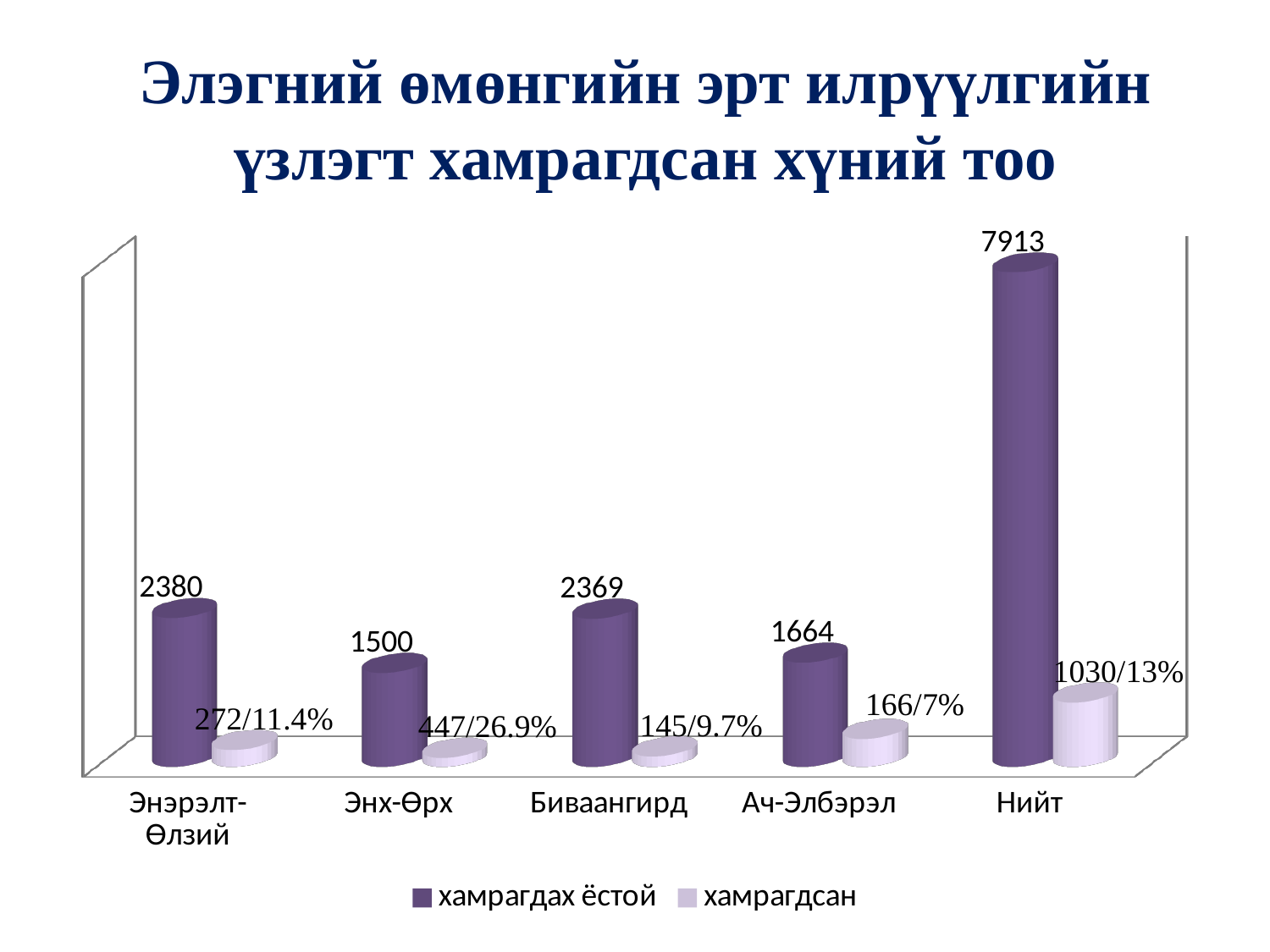
What is the value of 'хамрагдах ёстой' for Нийт? 7913 What data label is shown for 'хамрагдсан' for Биваангирд? 145/9.7% What data label is shown for 'хамрагдсан' for Ач-Элбэрэл? 166/7% How many series does the legend list? 2 Which category has the lowest 'хамрагдах ёстой' value? Энх-Өрх What kind of chart is shown on the slide? Bar chart What is the value of 'хамрагдах ёстой' for Энх-Өрх? 1500 Which is larger, the 'хамрагдах ёстой' value for Биваангирд or for Ач-Элбэрэл? Биваангирд What is the difference between the 'хамрагдах ёстой' values for Энэрэлт-Өлзий and Энх-Өрх? 880 What data label is shown for 'хамрагдсан' for Энэрэлт-Өлзий? 272/11.4% How many categories are shown on the x axis? 5 Excluding Нийт, which category has the highest 'хамрагдах ёстой' value? Энэрэлт-Өлзий